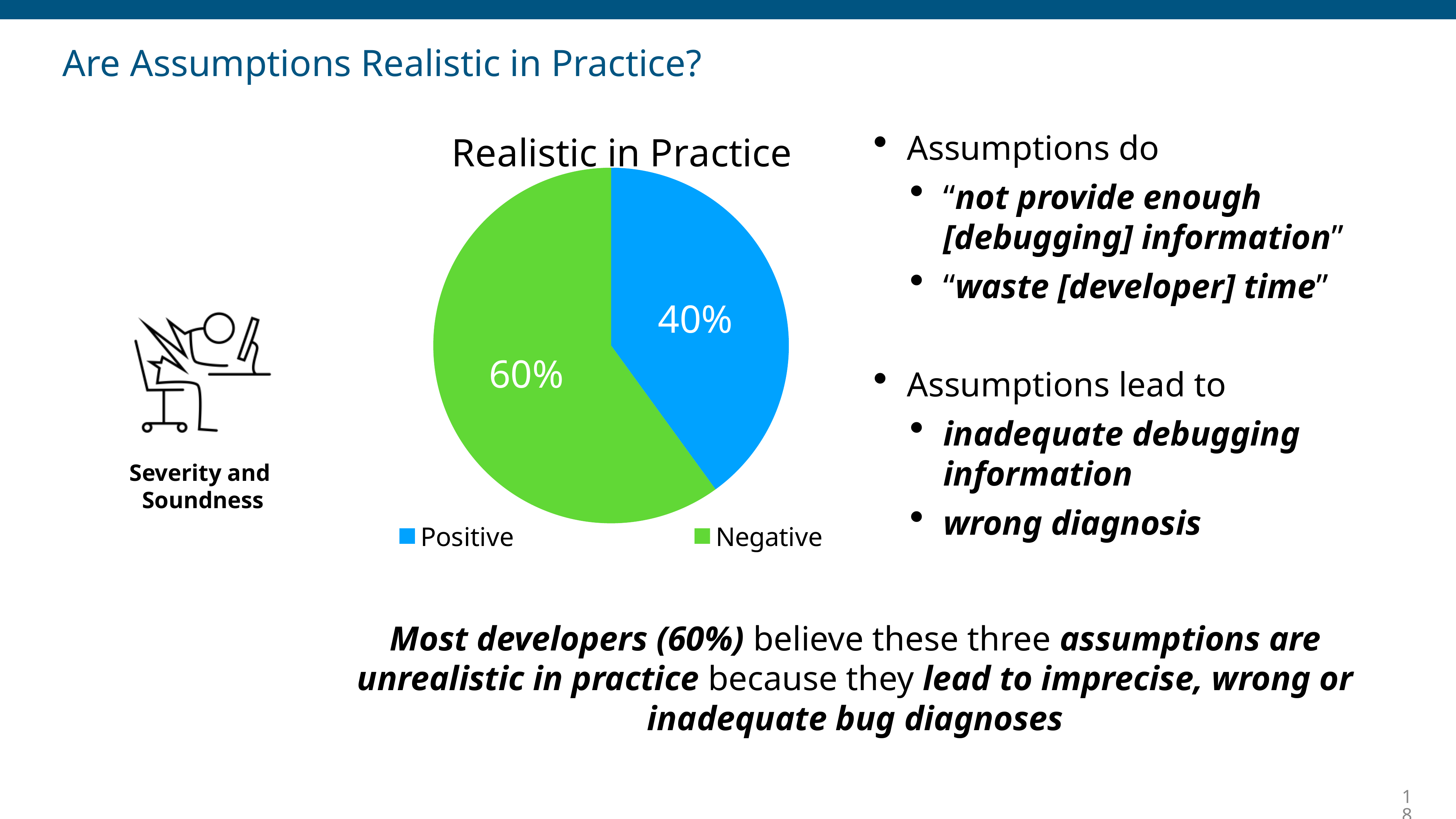
Is the value for Positive greater or less than 50%? less Which is larger, the Positive slice or the Negative slice? Negative What kind of chart is shown on the slide? pie chart Which slice of the pie is the largest? Negative What share of the pie is labelled Negative? 60% What colour is the Negative slice? green What share of the pie is labelled Positive? 40% What is the difference in percentage points between the Negative and Positive slices? 20% How many slices does the pie chart have? 2 How many entries does the legend list? 2 Which slice of the pie is the smallest? Positive What is the title of the chart? Realistic in Practice